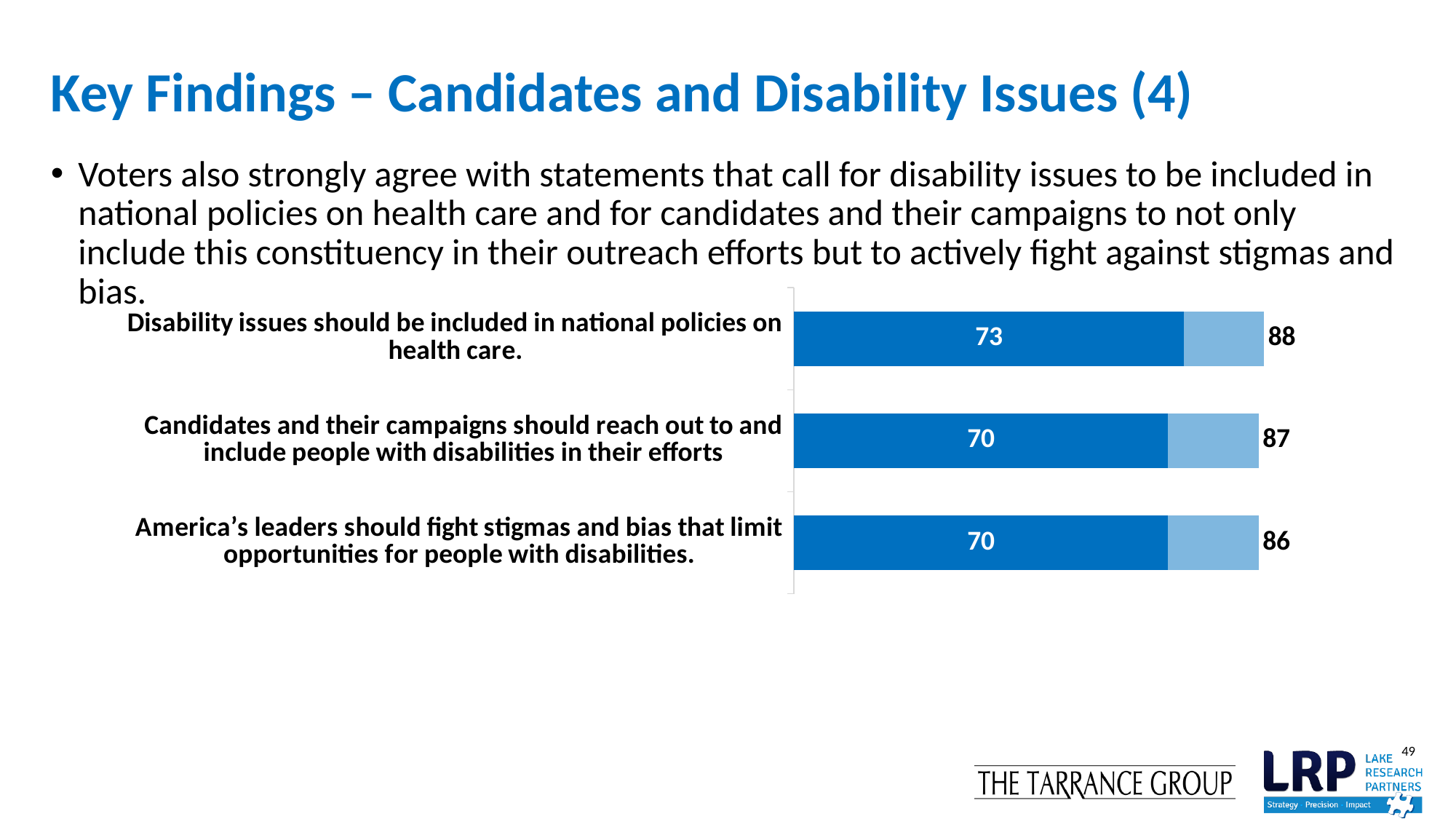
What is the dark blue segment value for "America's leaders should fight stigmas and bias that limit opportunities for people with disabilities."? 70 What is the total value shown at the end of the bar for "America's leaders should fight stigmas and bias that limit opportunities for people with disabilities."? 86 Which statement has the highest total value? Disability issues should be included in national policies on health care. What is the total value shown at the end of the bar for "Candidates and their campaigns should reach out to and include people with disabilities in their efforts"? 87 What kind of chart is shown on the slide? Stacked bar chart Which statement has the lowest total value? America's leaders should fight stigmas and bias that limit opportunities for people with disabilities. How many colour segments make up each bar in the chart? 2 What is the dark blue segment value for "Disability issues should be included in national policies on health care."? 73 What is the difference between the total values for "Disability issues should be included in national policies on health care." and "America's leaders should fight stigmas and bias that limit opportunities for people with disabilities."? 2 What is the difference between the dark blue segment values for "Disability issues should be included in national policies on health care." and "Candidates and their campaigns should reach out to and include people with disabilities in their efforts"? 3 How many statements (categories) are plotted in the chart? 3 Which has a larger total value: "Disability issues should be included in national policies on health care." or "Candidates and their campaigns should reach out to and include people with disabilities in their efforts"? Disability issues should be included in national policies on health care.